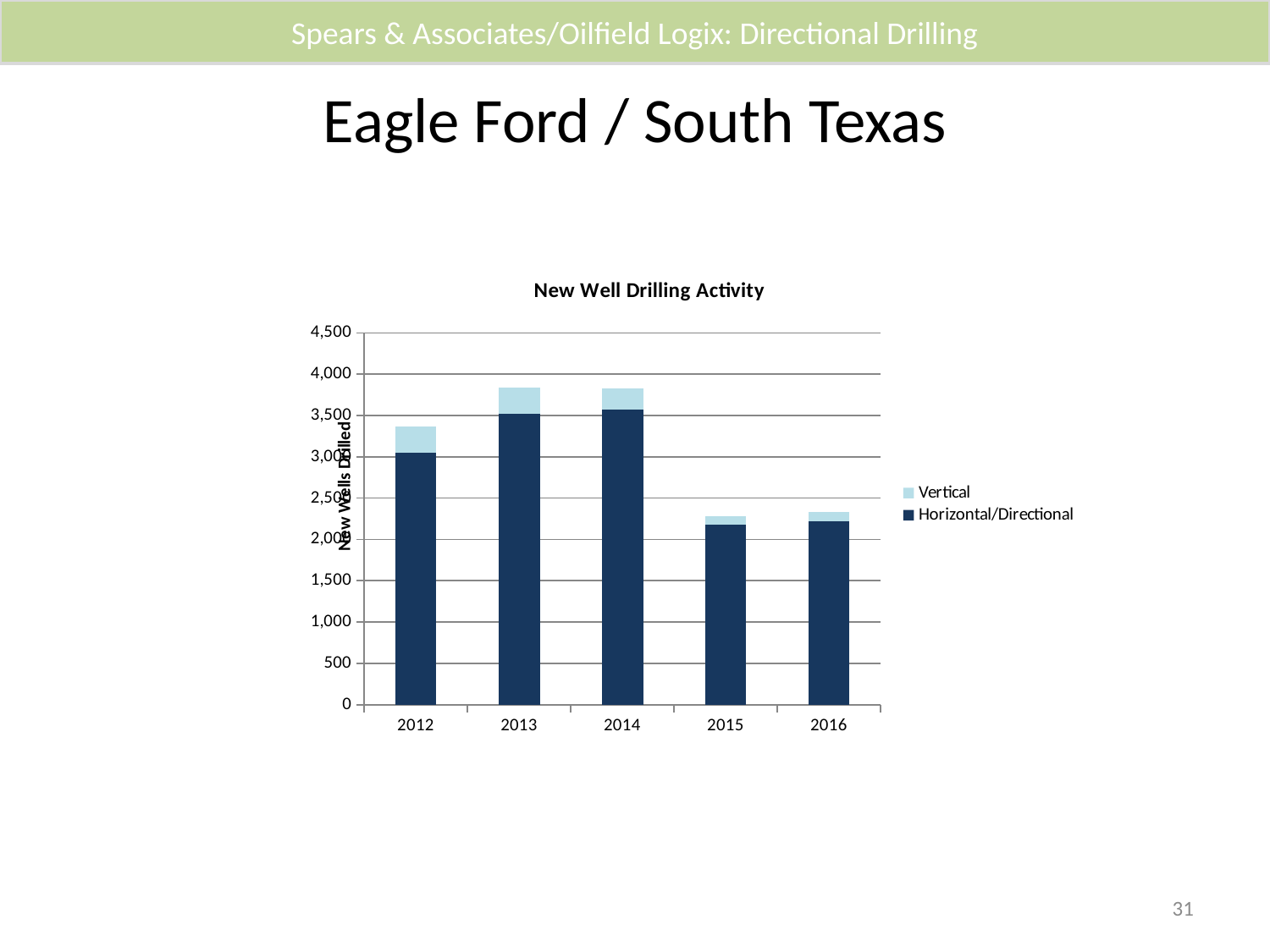
Do total new wells drilled rise or fall from 2014 to 2015? fall Which year has a larger total of new wells drilled, 2013 or 2015? 2013 How many series does the legend list? 2 Is the total number of new wells drilled in 2015 greater or less than 2,500? less Is the Horizontal/Directional value for 2016 greater or less than 2,000? greater What is the title of the chart? New Well Drilling Activity Is the Horizontal/Directional value for 2012 greater or less than 3,500? less Which two series are listed in the legend? Vertical and Horizontal/Directional What kind of chart is shown on the slide? Stacked bar chart How many years are shown on the x axis? 5